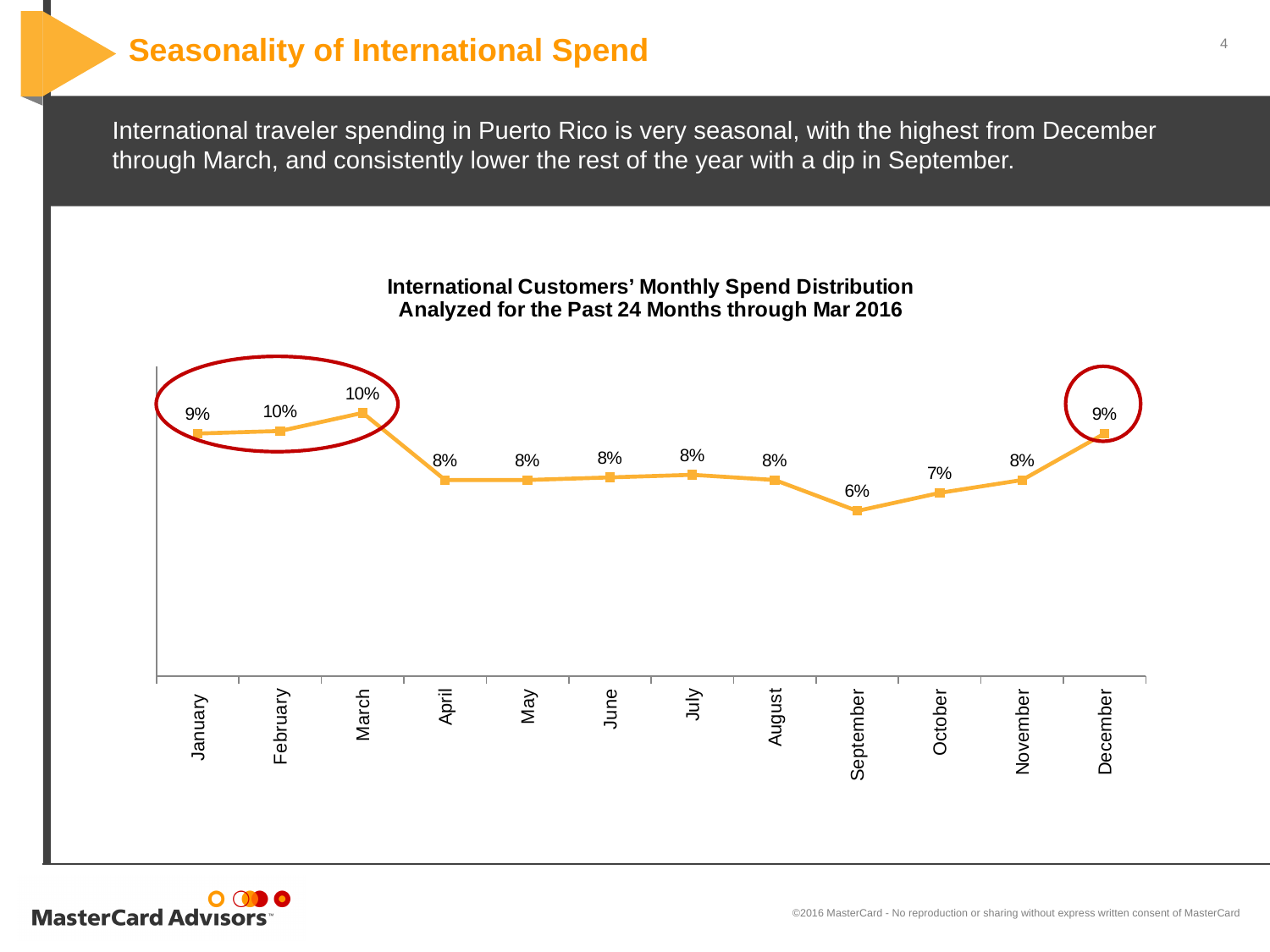
What is the value for September? 6% What is the title of the chart? International Customers' Monthly Spend Distribution Analyzed for the Past 24 Months through Mar 2016 What is the value for March? 10% What is the difference between the values for March and September? 4% What is the value for October? 7% Which month has the lowest value? September What is the difference between the values for January and October? 2% Which is larger, the value for February or the value for April? February What is the value for December? 9% How many months are plotted on the chart? 12 What kind of chart is shown? Line chart Do the values rise or fall from March to April? Fall